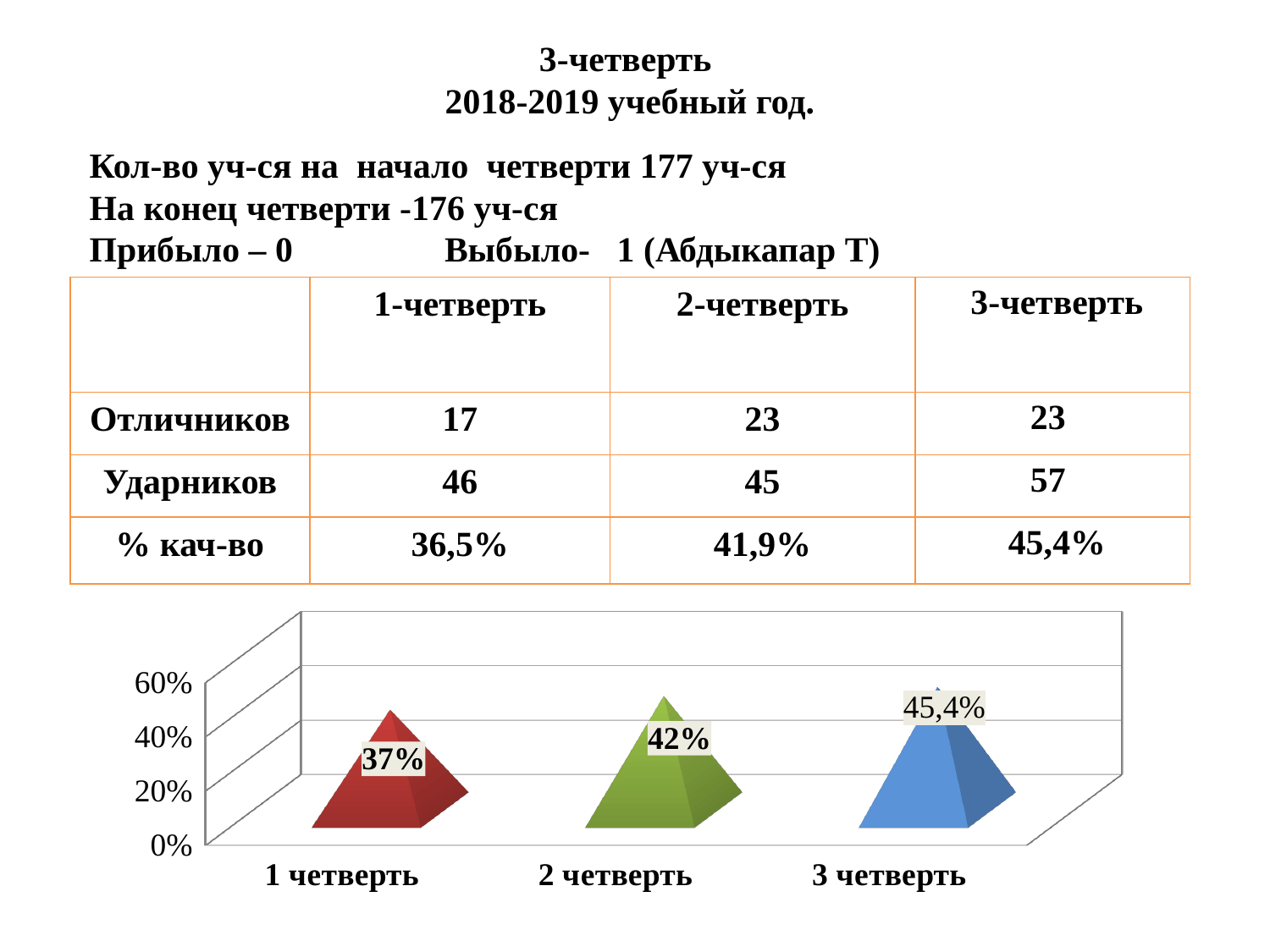
Which is larger in the chart, the value for 1 четверть or the value for 2 четверть? 2 четверть Is the value for 3 четверть greater or less than 60%? less Which category has the highest value in the chart? 3 четверть What is the difference between the values for 3 четверть and 2 четверть in the chart? 3,4% Do the values rise or fall from 1 четверть to 3 четверть in the chart? rise What kind of chart is shown on the slide? bar chart Which category has the lowest value in the chart? 1 четверть What is the difference between the values for 2 четверть and 1 четверть in the chart? 5% What value is shown for 2 четверть in the chart? 42% What value is shown for 1 четверть in the chart? 37% How many categories are shown on the x axis of the chart? 3 What value is shown for 3 четверть in the chart? 45,4%